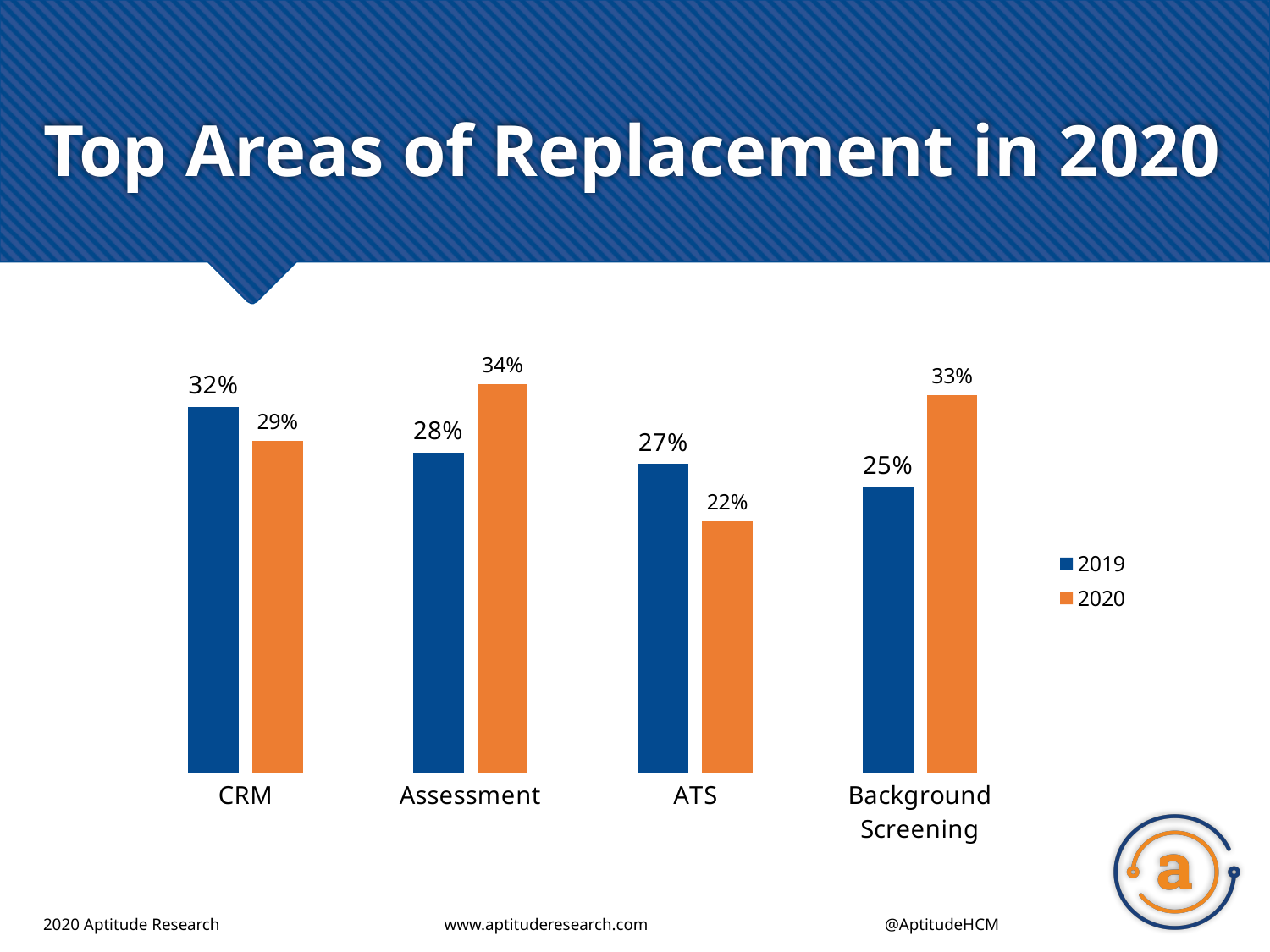
What is the 2020 value for ATS? 22% What is the difference between the 2020 and 2019 values for Background Screening? 8% What is the 2020 value for Assessment? 34% How many categories are shown on the x axis? 4 Which colour represents the 2020 series in the legend? Orange What is the 2019 value for Background Screening? 25% What is the 2019 value for CRM? 32% Which category has the lowest 2019 value? Background Screening Which is larger for ATS, the 2019 value or the 2020 value? 2019 Which category has the highest 2020 value? Assessment How many series does the legend list? 2 What kind of chart is shown on the slide? Bar chart